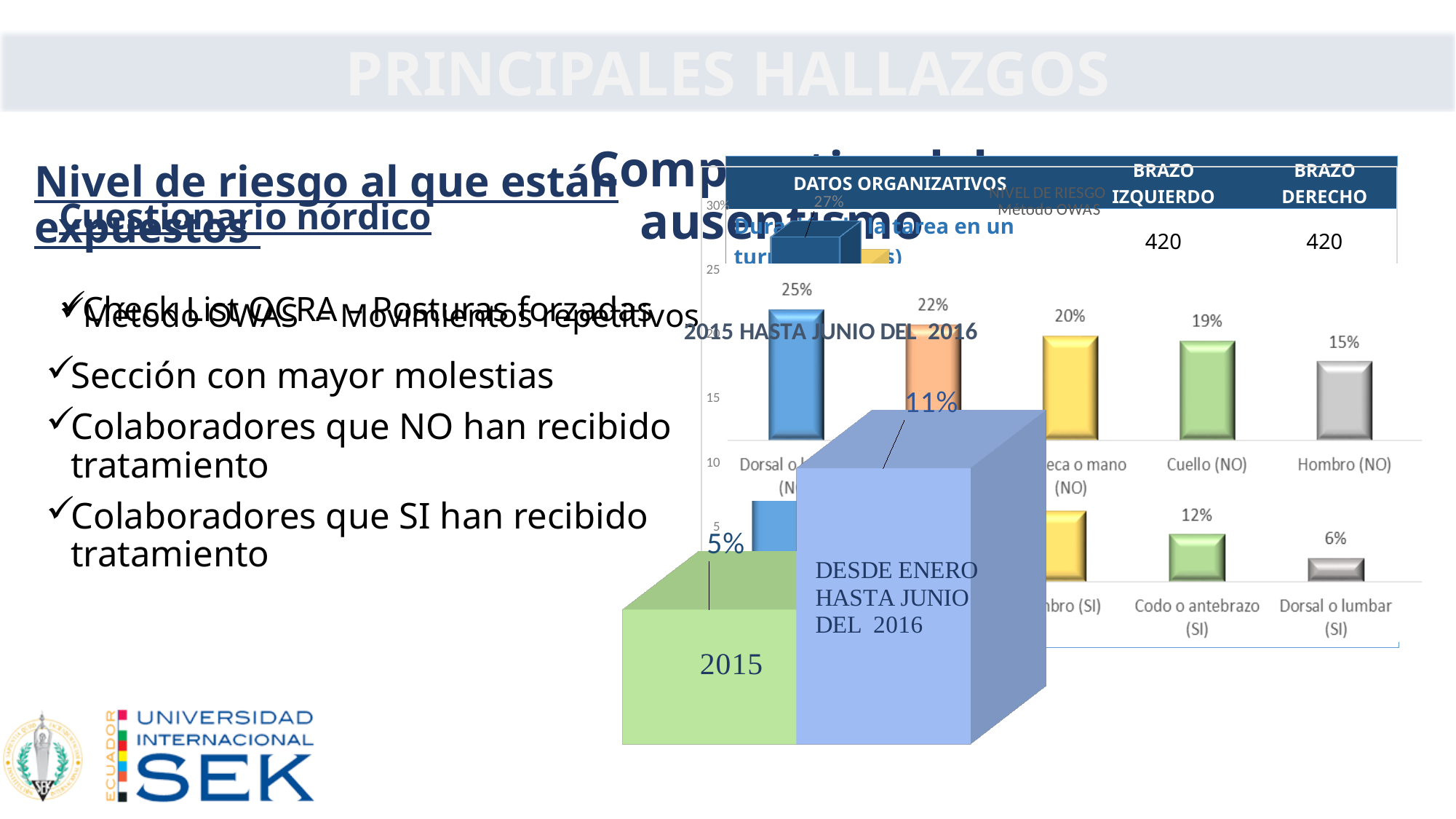
In the front 3D bar chart comparing absenteeism, how many bars are plotted? 2 In the front 3D bar chart comparing absenteeism, which period has the higher value, 2015 or DESDE ENERO HASTA JUNIO DEL 2016? DESDE ENERO HASTA JUNIO DEL 2016 In the background bar chart of body sections, which is larger, Cuello (NO) or Hombro (NO)? Cuello (NO) In the background bar chart of body sections, what is the value for Codo o antebrazo (SI)? 12% In the front 3D bar chart comparing absenteeism, what is the value for 2015? 5% In the front 3D bar chart comparing absenteeism, what is the difference between the 2016 value and the 2015 value? 6% In the background bar chart of body sections, what is the value for Dorsal o lumbar (SI)? 6% In the background bar chart of body sections, what is the value for Cuello (NO)? 19% What kind of chart is the front chart comparing 2015 and 2016? Bar chart In the background bar chart of body sections, what is the value for Hombro (NO)? 15% In the front 3D bar chart comparing absenteeism, what is the value for DESDE ENERO HASTA JUNIO DEL 2016? 11% In the background bar chart of body sections, what is the difference between Codo o antebrazo (SI) and Dorsal o lumbar (SI)? 6%